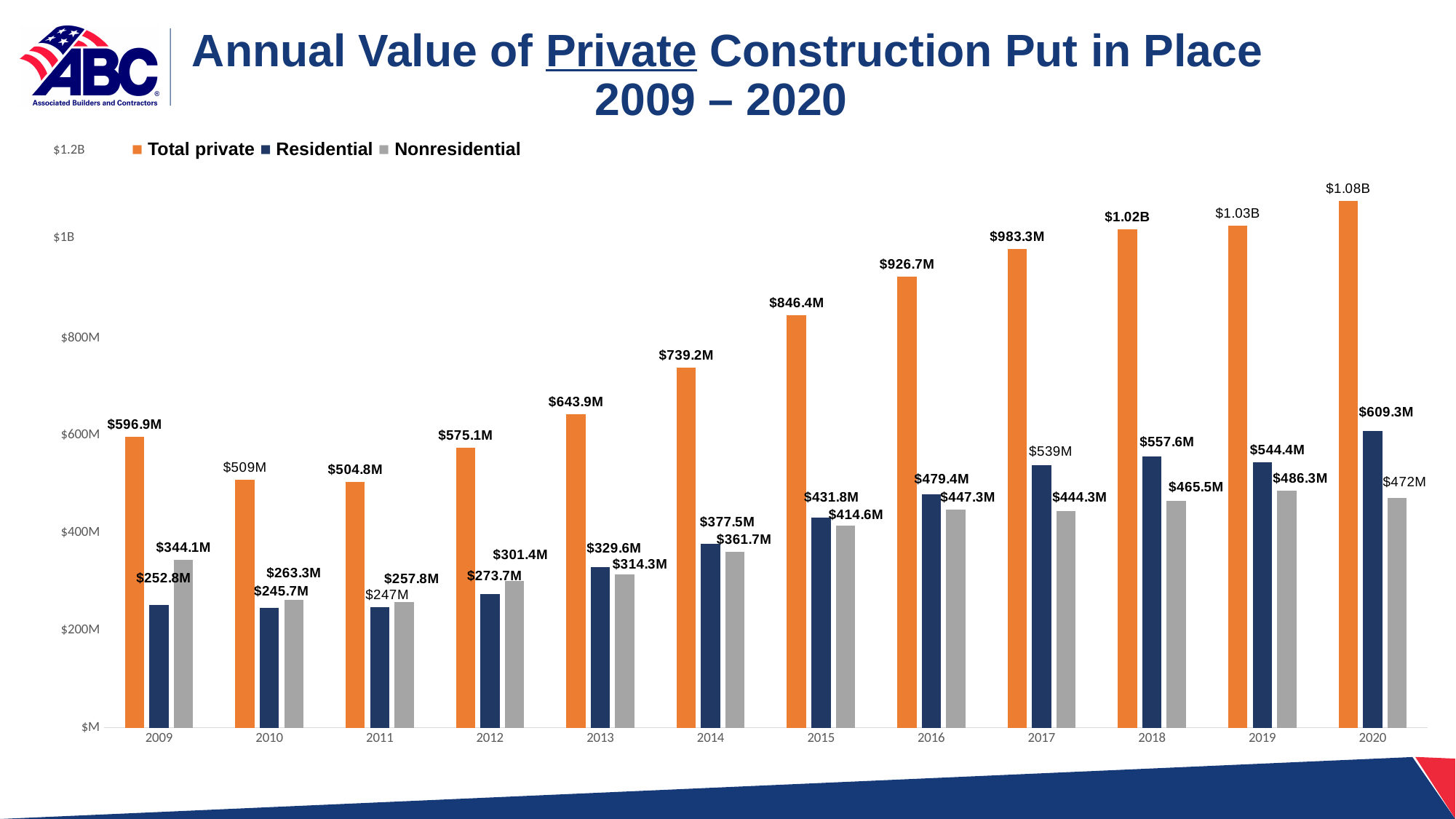
Which year has the highest Nonresidential value? 2019 Which year has the highest Total private value? 2020 What is the Residential value for 2020? $609.3M Does the Total private value generally rise or fall from 2011 to 2020? Rise What is the Nonresidential value for 2009? $344.1M Which year has the lowest Residential value? 2010 In 2009, which is larger: Residential or Nonresidential? Nonresidential What kind of chart is shown on the slide? Bar chart How many series does the legend list? 3 What is the Total private value for 2015? $846.4M What is the difference between the Residential values for 2020 and 2019? $64.9M How many years are shown on the x axis? 12